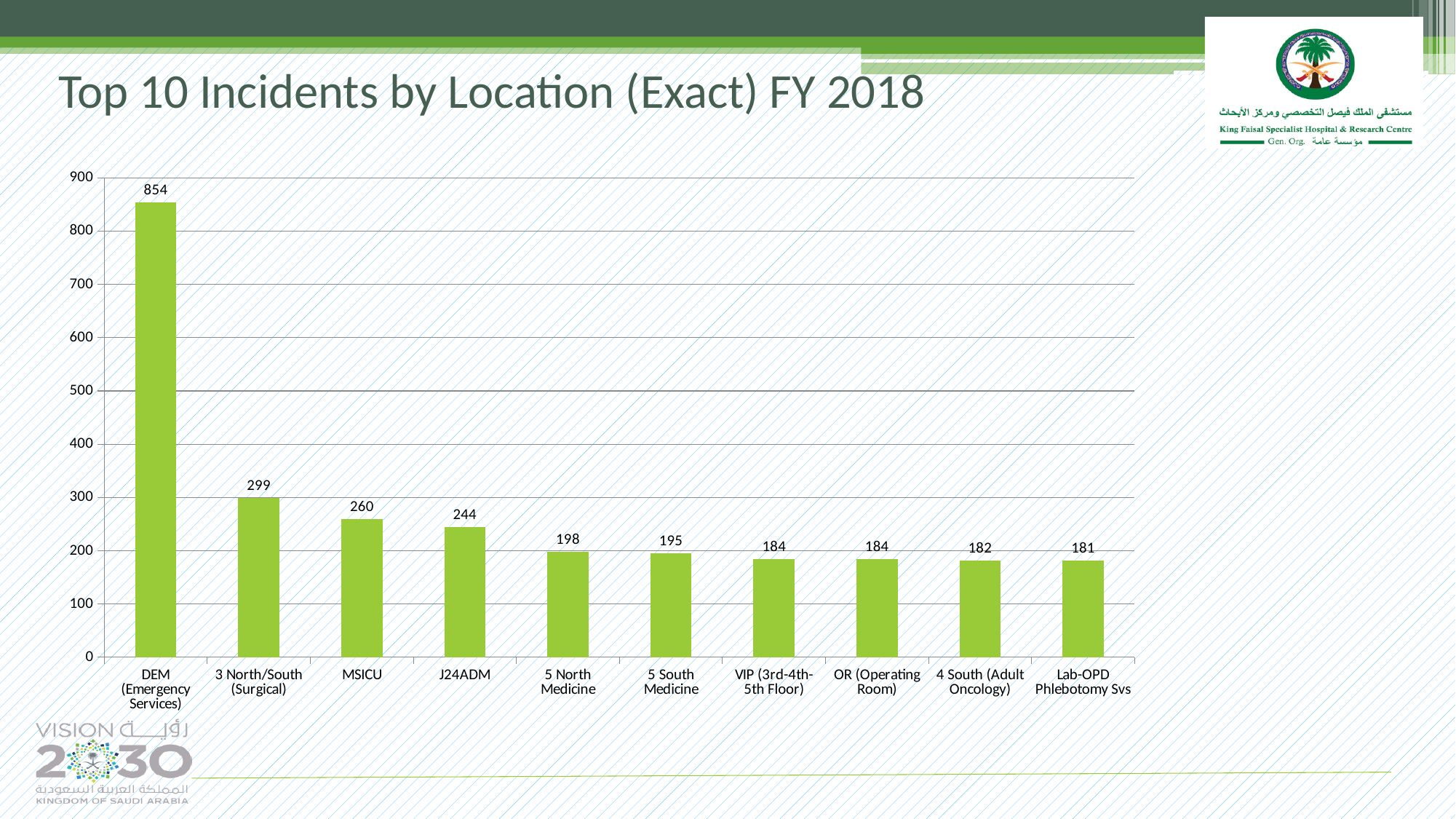
What is the difference between the values for DEM (Emergency Services) and 3 North/South (Surgical)? 555 Is the value for 3 North/South (Surgical) greater or less than 200? greater What is the value for MSICU? 260 What kind of chart is shown on the slide? bar chart Which location has the highest number of incidents? DEM (Emergency Services) How many locations are shown on the chart? 10 What is the title of the chart? Top 10 Incidents by Location (Exact) FY 2018 What is the value for DEM (Emergency Services)? 854 What is the difference between the values for J24ADM and 5 North Medicine? 46 Which location has the lowest number of incidents? Lab-OPD Phlebotomy Svs Which is larger, the value for MSICU or the value for J24ADM? MSICU What is the value for 4 South (Adult Oncology)? 182